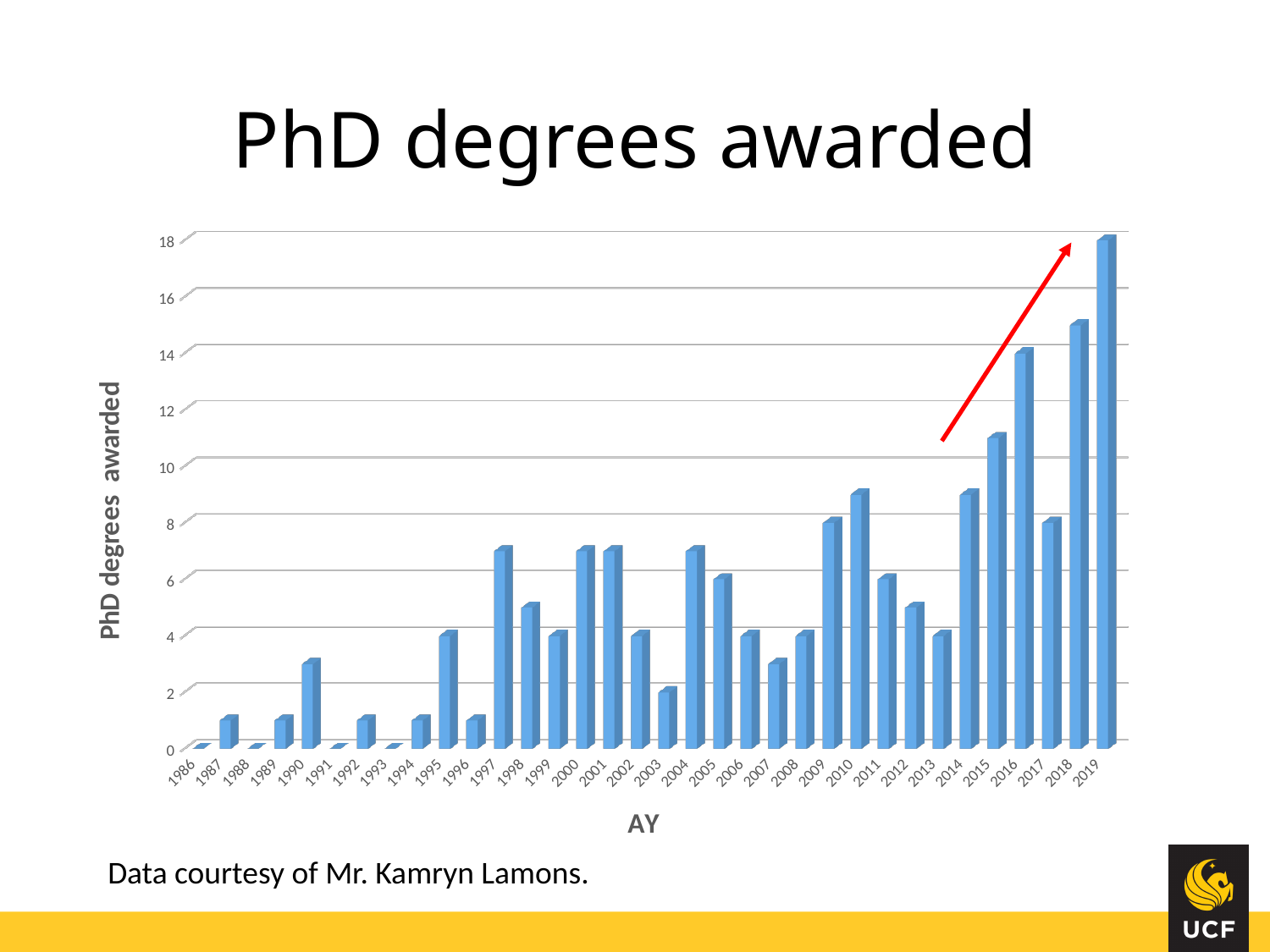
What is the title of the chart? PhD degrees awarded How many PhD degrees were awarded in 2019? 18 Which year has the larger value, 2010 or 2013? 2010 How many PhD degrees were awarded in 2016? 14 Is the value for 2015 greater or less than 10? greater Is the value for 2003 greater or less than 4? less What kind of chart is shown on the slide? bar chart What is the label on the x axis of the chart? AY Which year has the highest number of PhD degrees awarded? 2019 How many years (categories) are shown on the x axis? 34 Is the value for 2018 greater or less than 14? greater Overall, do the values rise or fall from 1986 to 2019? rise